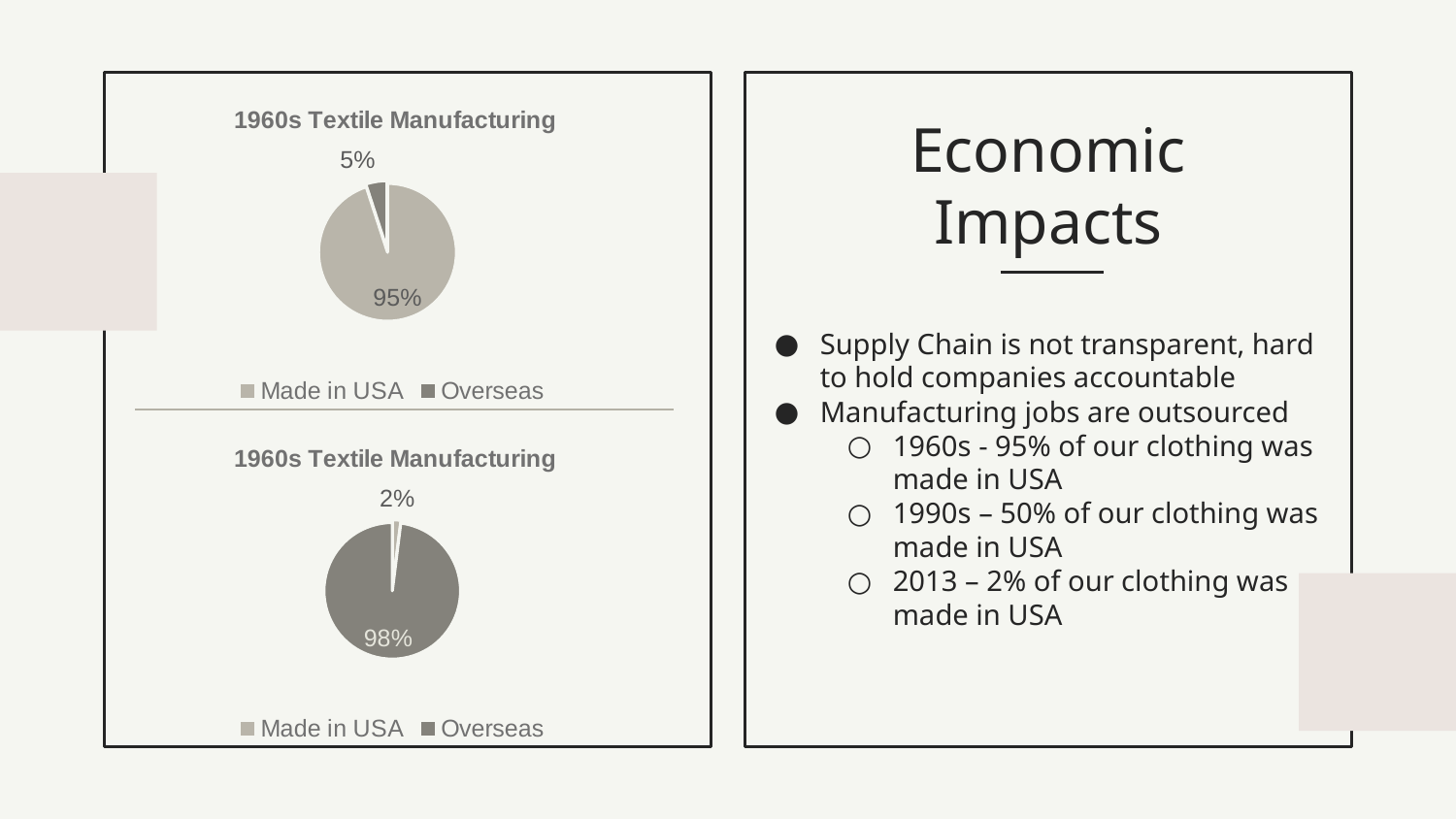
In the top pie chart, which slice is the largest? Made in USA In the bottom pie chart, which slice is the smallest? Made in USA In the top pie chart, what share is Overseas? 5% In the bottom pie chart, what share is Made in USA? 2% What is the title of the top pie chart? 1960s Textile Manufacturing In the bottom pie chart, which is larger, Made in USA or Overseas? Overseas How many slices does the bottom pie chart have? 2 In the bottom pie chart, what share is Overseas? 98% How many entries does the legend of the top pie chart list? 2 What type of chart is the top chart on the slide? Pie chart In the top pie chart, what share is Made in USA? 95% In the top pie chart, what is the difference between the Made in USA and Overseas shares? 90%